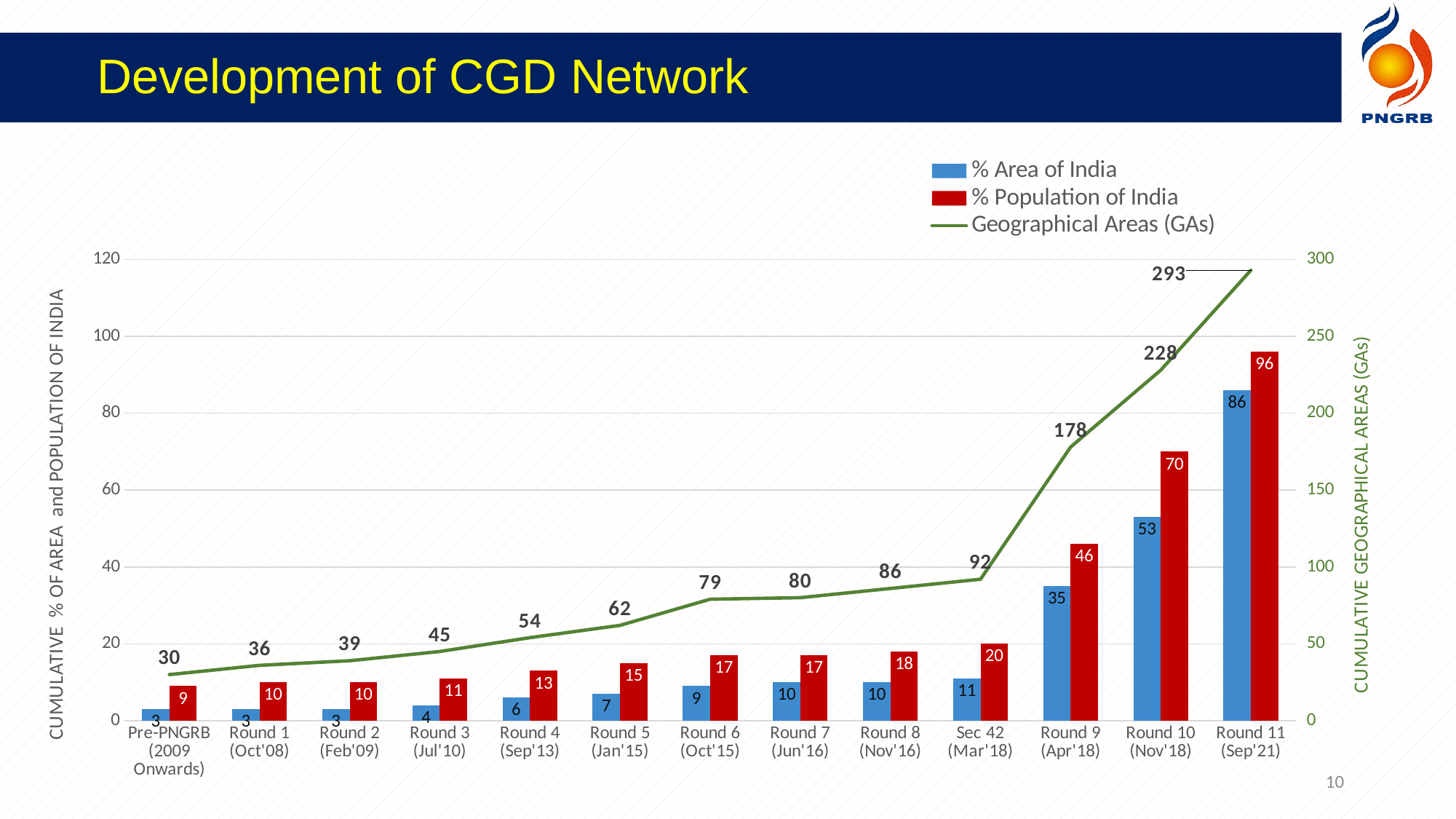
What is the % Population of India value for Round 11 (Sep'21)? 96 What is the lowest Geographical Areas (GAs) value shown on the chart? 30 What is the Geographical Areas (GAs) value for Round 9 (Apr'18)? 178 How many series does the legend list? 3 What colour are the % Population of India bars? Red What is the difference between the Geographical Areas (GAs) values for Round 11 (Sep'21) and Round 10 (Nov'18)? 65 Which category has the highest Geographical Areas (GAs) value? Round 11 (Sep'21) Which is larger for Round 9 (Apr'18): % Area of India or % Population of India? % Population of India How many categories are shown on the x axis? 13 What is the difference between the % Population of India values for Round 11 (Sep'21) and Round 10 (Nov'18)? 26 Does the Geographical Areas (GAs) line rise or fall from left to right? rise What is the % Area of India value for Round 10 (Nov'18)? 53